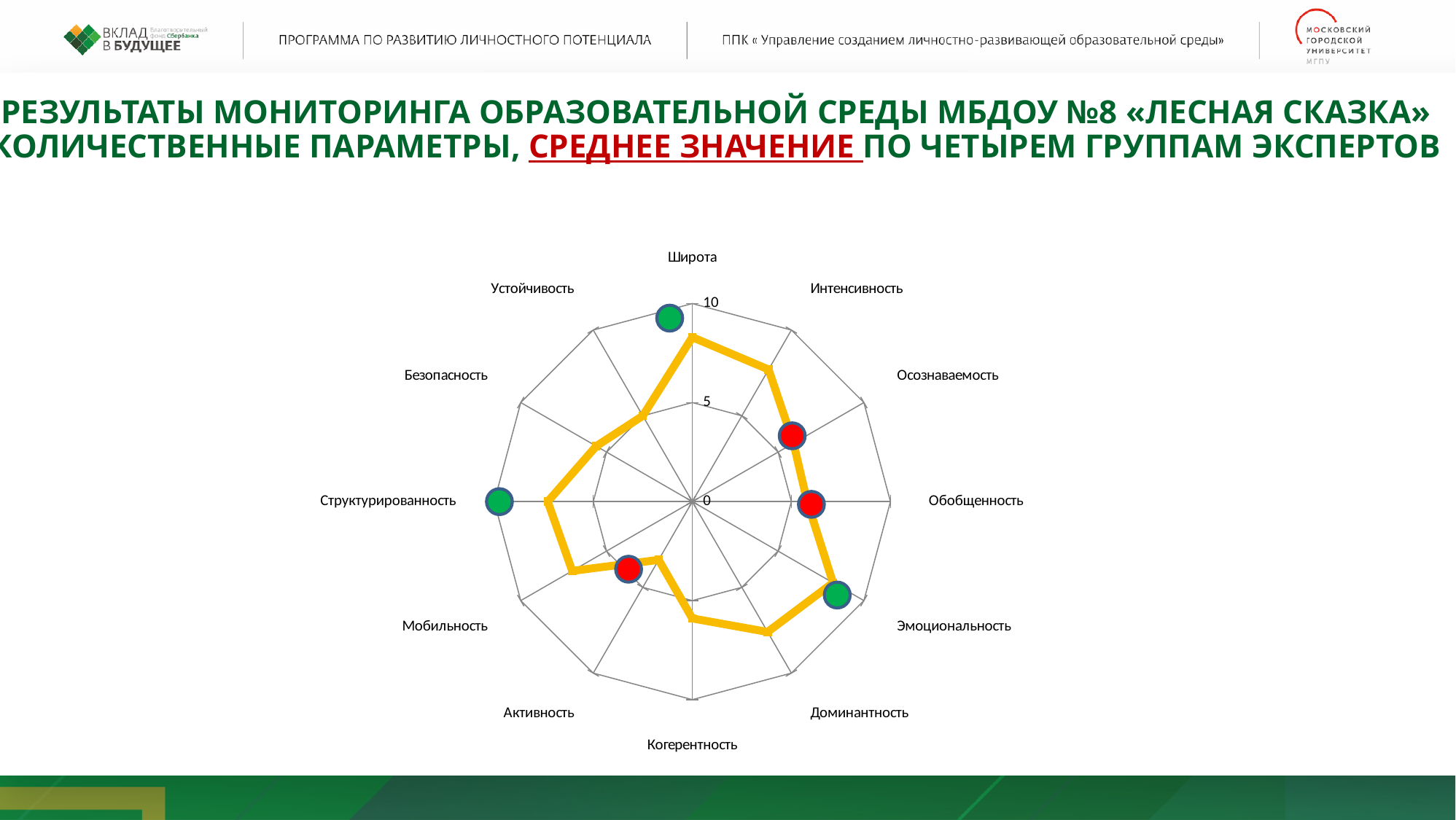
Is the value for Структурированность greater or less than 5? greater Is the value for Широта greater or less than 5? greater What kind of chart is shown on the slide? Radar chart Is the value for Интенсивность greater or less than 5? greater Which is larger, the value for Структурированность or the value for Когерентность? Структурированность What is the maximum value shown on the radar chart's axis scale? 10 What colour is the data line on the radar chart? Yellow Which is larger, the value for Широта or the value for Активность? Широта How many categories (parameters) are plotted on the radar chart? 12 Which category has the lowest value on the radar chart? Активность